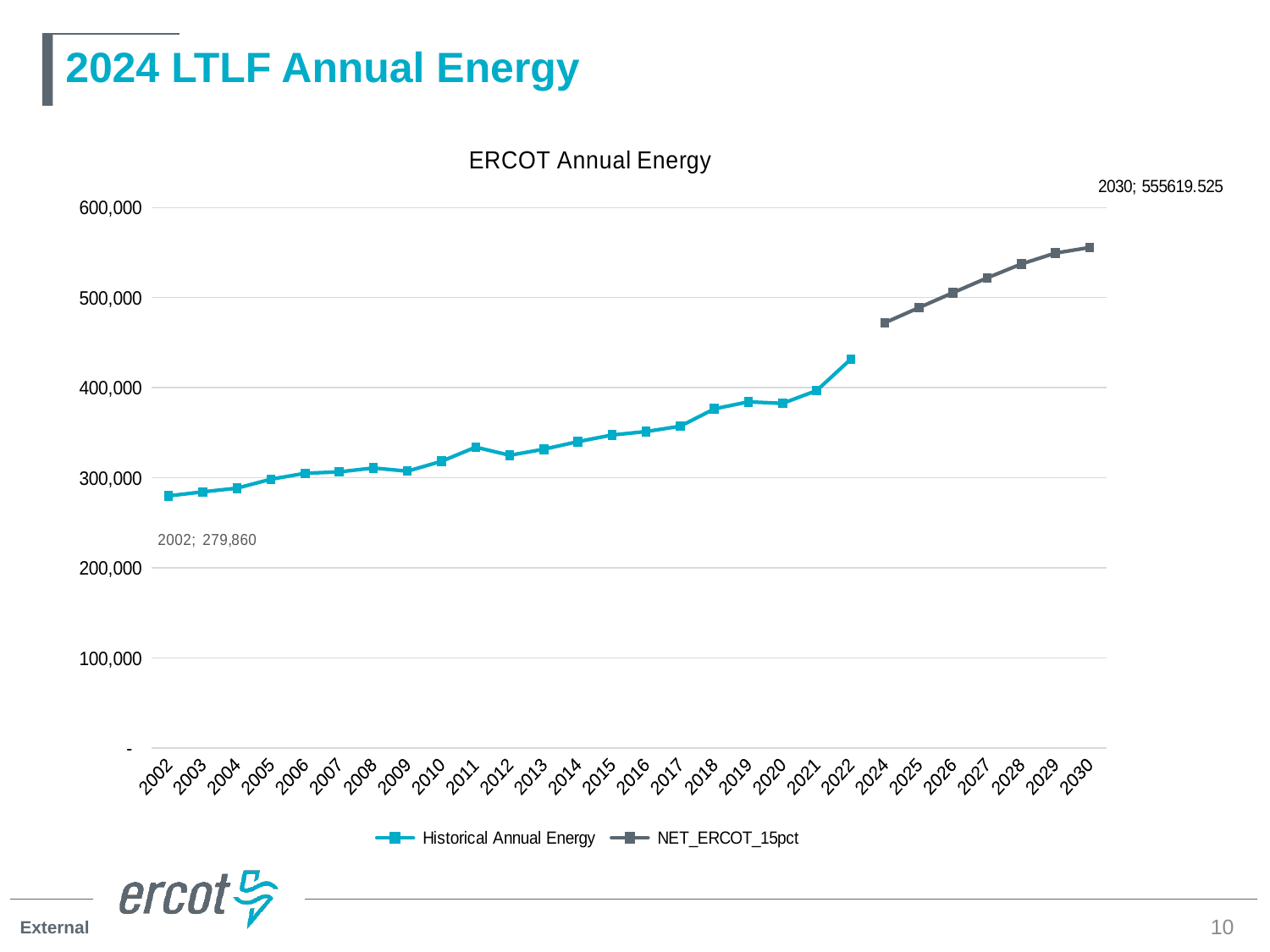
How many years are shown on the x axis? 28 How many series does the legend list? 2 Is the NET_ERCOT_15pct value for 2028 greater or less than 500,000? greater What is the NET_ERCOT_15pct value for 2030? 555619.525 Do the values generally rise or fall from 2002 to 2030? Rise Is the Historical Annual Energy value for 2022 greater or less than 400,000? greater Which is larger, the value for 2011 or the value for 2012? 2011 What kind of chart is shown on the slide? Line chart What is the Historical Annual Energy value for 2002? 279,860 Is the Historical Annual Energy value for 2018 greater or less than 400,000? less Which year has the lowest value on the chart? 2002 Which year has the highest value on the chart? 2030